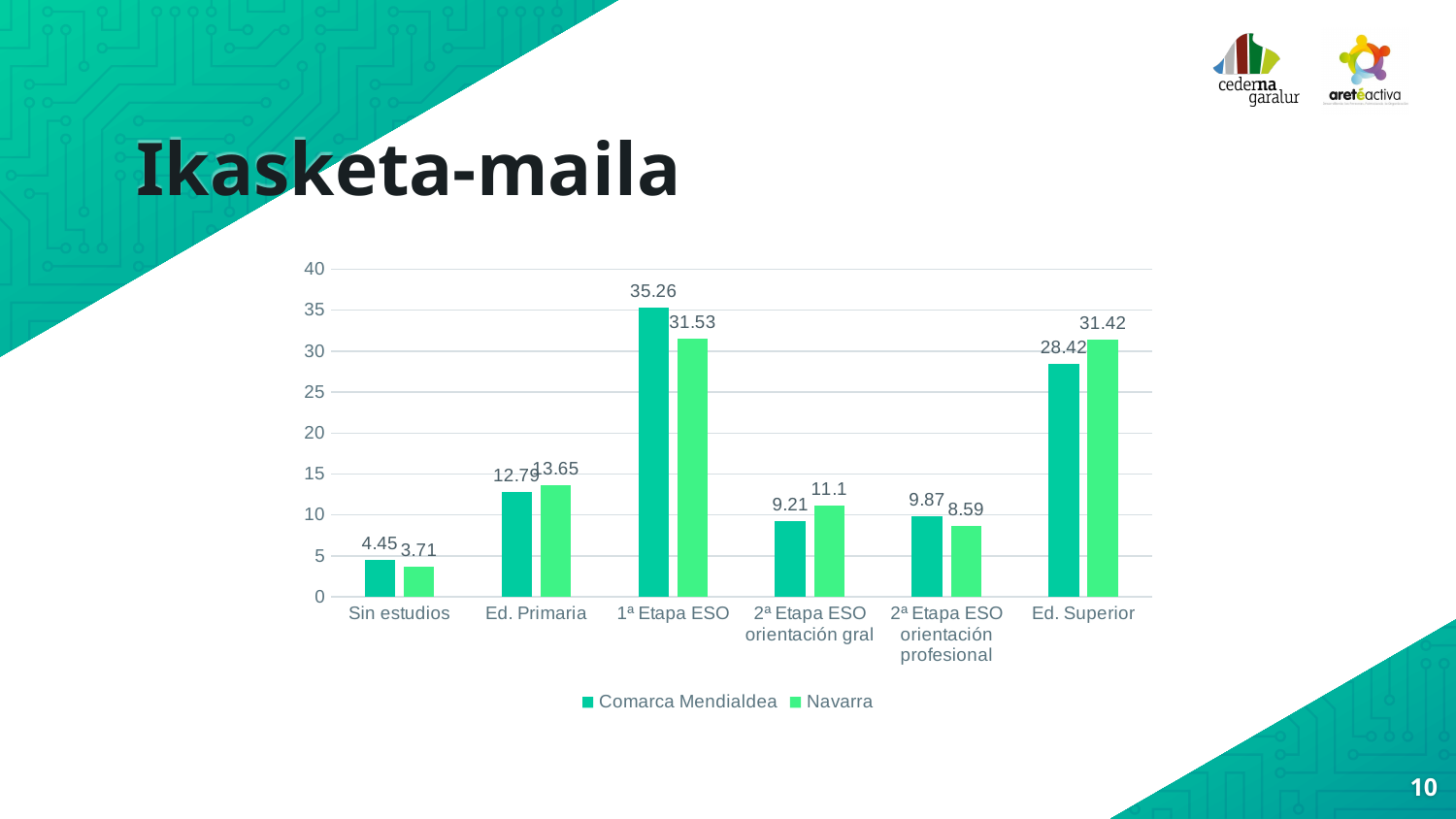
What kind of chart is shown on the slide? bar chart In the Ed. Superior category, which series has the larger value, Comarca Mendialdea or Navarra? Navarra What is the value for Navarra in the Sin estudios category? 3.71 How many series does the legend list? 2 What is the value for Comarca Mendialdea in the 2ª Etapa ESO orientación profesional category? 9.87 What is the value for Navarra in the Ed. Superior category? 31.42 Which category has the lowest value for Navarra? Sin estudios Which category has the highest value for Comarca Mendialdea? 1ª Etapa ESO What is the difference between the Comarca Mendialdea and Navarra values in the 1ª Etapa ESO category? 3.73 Is the value for Comarca Mendialdea in the Ed. Superior category greater or less than 30? less What is the value for Comarca Mendialdea in the 1ª Etapa ESO category? 35.26 How many categories are shown on the x axis? 6